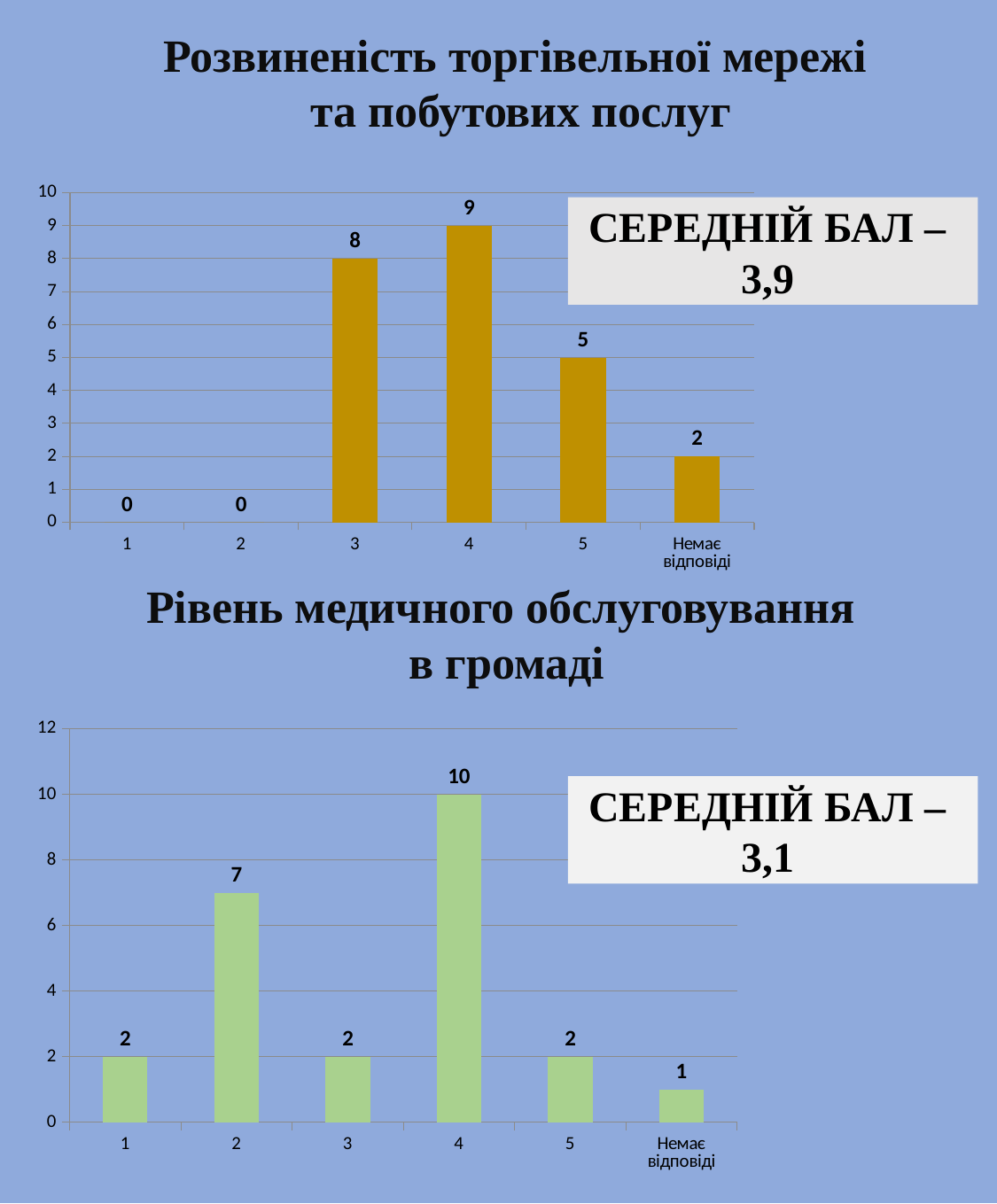
In the bottom chart (Рівень медичного обслуговування в громаді), what is the value for category 2? 7 In the bottom chart (Рівень медичного обслуговування в громаді), which category has the lowest value? Немає відповіді What kind of chart is the bottom chart (Рівень медичного обслуговування в громаді)? bar chart In the top chart (Розвиненість торгівельної мережі та побутових послуг), what is the difference between the values for category 3 and category 5? 3 In the top chart (Розвиненість торгівельної мережі та побутових послуг), what average score (СЕРЕДНІЙ БАЛ) is shown? 3,9 In the bottom chart (Рівень медичного обслуговування в громаді), what is the difference between the values for category 4 and category 2? 3 In the top chart (Розвиненість торгівельної мережі та побутових послуг), what is the value for 'Немає відповіді'? 2 In the bottom chart (Рівень медичного обслуговування в громаді), which category has the highest value? 4 In the top chart (Розвиненість торгівельної мережі та побутових послуг), which category has the highest value? 4 In the bottom chart (Рівень медичного обслуговування в громаді), is the value for category 2 larger or smaller than the value for category 4? smaller In the top chart (Розвиненість торгівельної мережі та побутових послуг), what is the value for category 4? 9 In the top chart (Розвиненість торгівельної мережі та побутових послуг), how many categories are shown on the x axis? 6